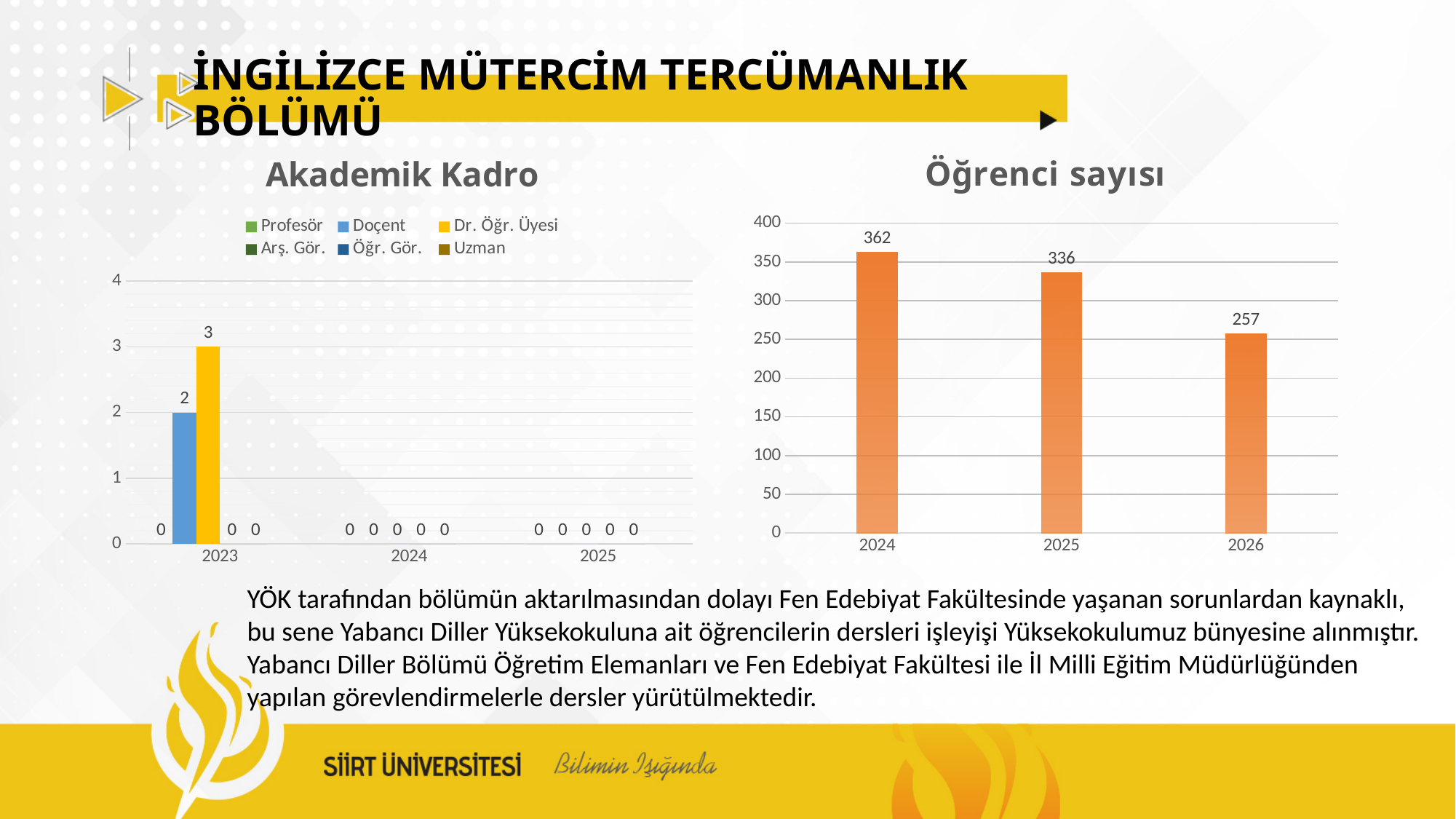
In the 'Öğrenci sayısı' chart, which year has the lowest value? 2026 In the 'Öğrenci sayısı' chart, do the values rise or fall from 2024 to 2026? fall In the 'Akademik Kadro' chart, what is the value for Doçent in 2023? 2 In the 'Öğrenci sayısı' chart, what is the value for 2026? 257 In the 'Akademik Kadro' chart, which is larger in 2023: Doçent or Dr. Öğr. Üyesi? Dr. Öğr. Üyesi In the 'Akademik Kadro' chart, how many series does the legend list? 6 In the 'Akademik Kadro' chart, what is the value for Dr. Öğr. Üyesi in 2023? 3 In the 'Öğrenci sayısı' chart, what is the difference between the values for 2024 and 2025? 26 In the 'Öğrenci sayısı' chart, how many years are shown on the x axis? 3 In the 'Öğrenci sayısı' chart, what is the value for 2024? 362 What kind of chart is the 'Öğrenci sayısı' chart? bar chart In the 'Öğrenci sayısı' chart, which year has the highest value? 2024